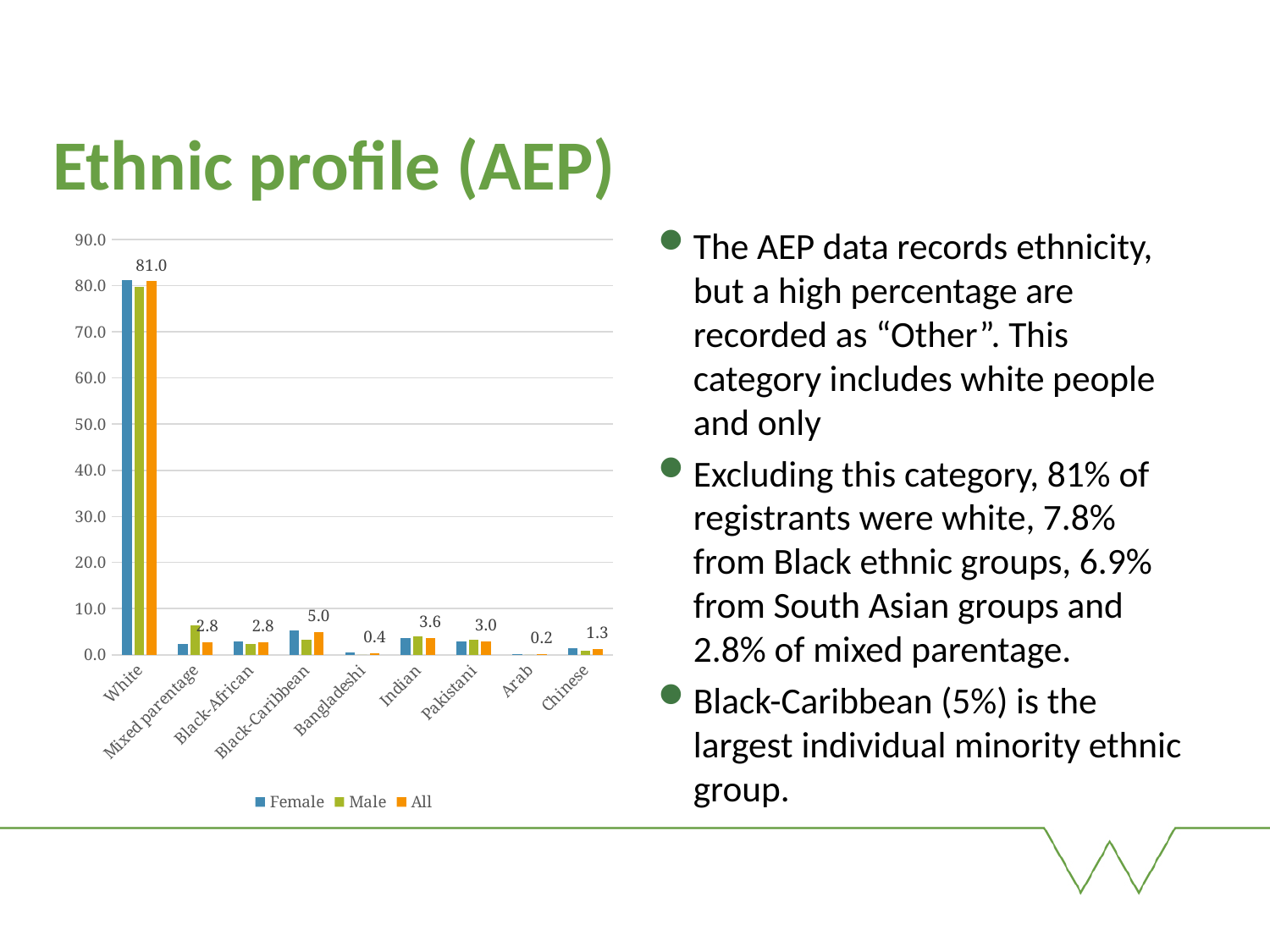
What is the value for All in the Arab category? 0.2 Which category has the lowest value for the All series? Arab Is the Female value for Black-Caribbean greater or less than 10.0? less How many series does the legend list? 3 What is the value for All in the White category? 81.0 What is the value for All in the Black-Caribbean category? 5.0 What kind of chart is shown on the slide? Bar chart What is the difference between the All values for Black-Caribbean and Indian? 1.4 Which is larger for the All series: Pakistani or Chinese? Pakistani What is the value for All in the Indian category? 3.6 How many ethnic categories are shown on the x axis? 9 Which category has the highest value for the All series? White